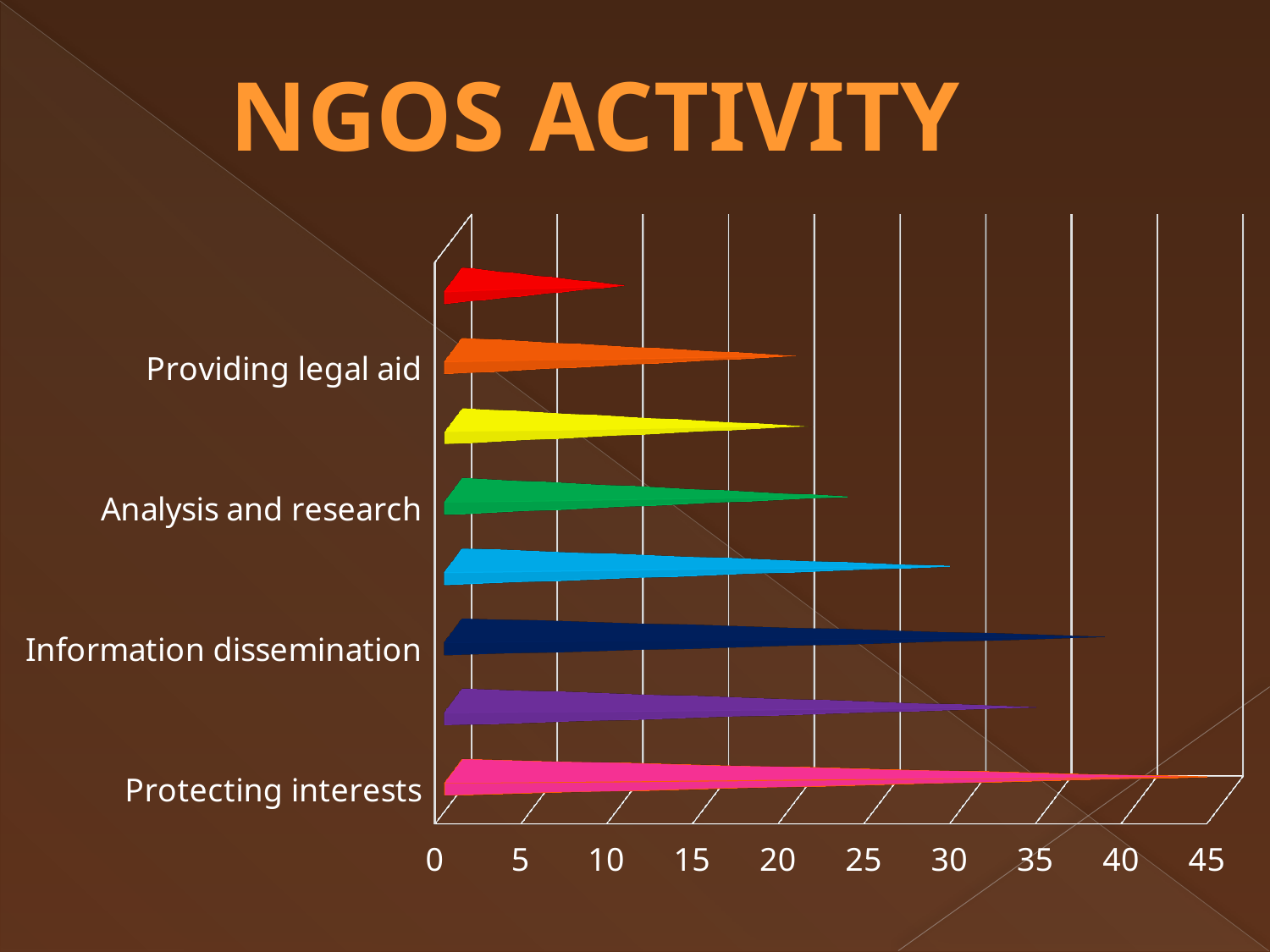
Is the value for Protecting interests greater or less than 40? greater How many bars are plotted in the chart? 8 What kind of chart is shown on the slide? bar chart What is the highest value shown on the horizontal axis? 45 Which is larger, the value for Protecting interests or the value for Providing legal aid? Protecting interests What is the title of the chart? NGOS ACTIVITY Is the value for Information dissemination greater or less than 35? greater Is the value for Providing legal aid greater or less than 25? less Which is larger, the value for Information dissemination or the value for Analysis and research? Information dissemination Which labelled category has the highest value? Protecting interests